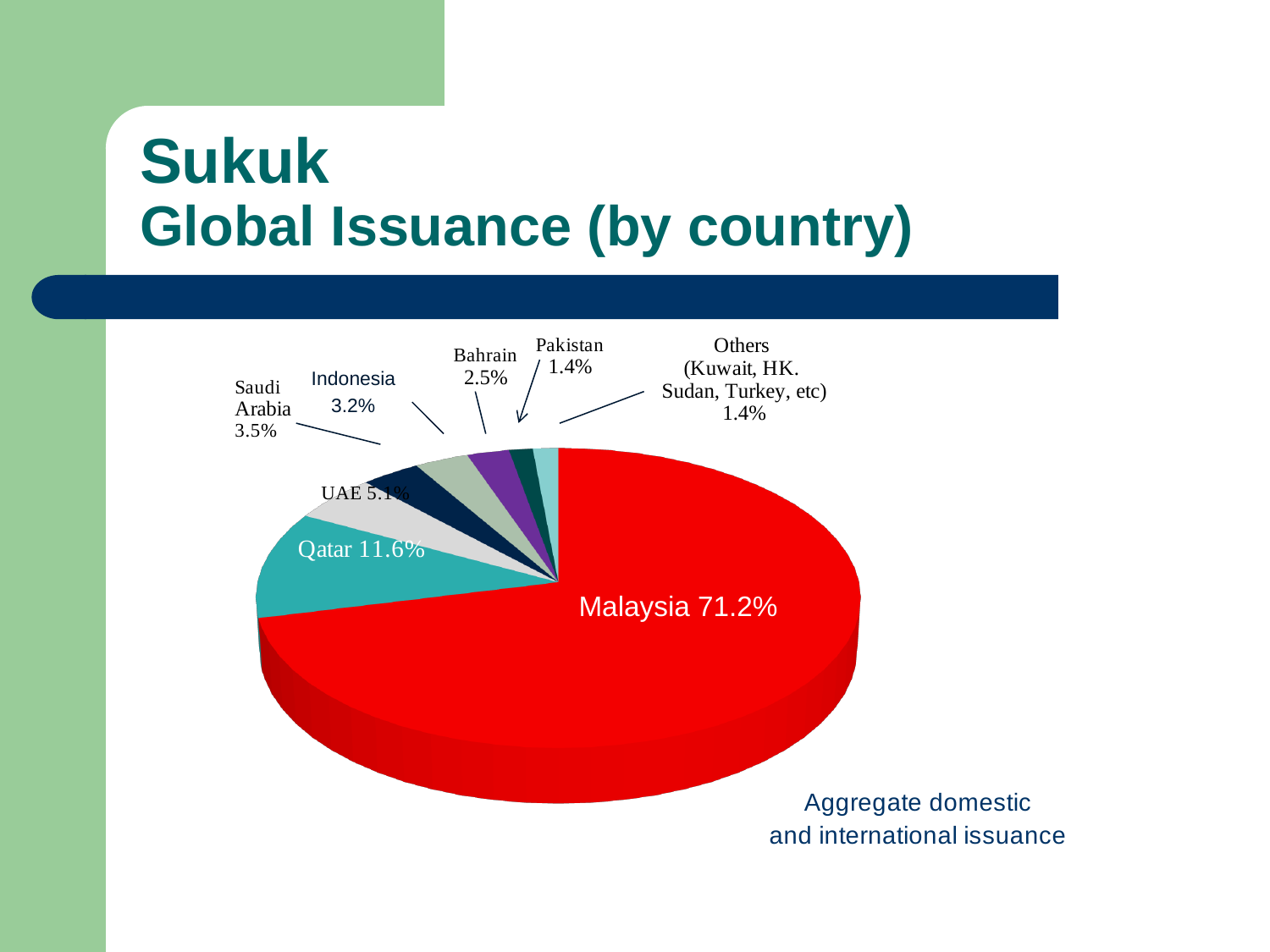
What kind of chart is shown on the slide? Pie chart What is the value shown for Qatar? 11.6% What is the value shown for Pakistan? 1.4% Which slice is larger, Indonesia or Saudi Arabia? Saudi Arabia What is the value shown for Saudi Arabia? 3.5% What share of global sukuk issuance does Malaysia account for? 71.2% What is the difference between Malaysia's share and Qatar's share? 59.6% Which country has the largest slice of the pie? Malaysia What is the value shown for UAE? 5.1% What is the value shown for Bahrain? 2.5% What is the title of the slide containing the chart? Sukuk Global Issuance (by country) How many slices does the pie chart have? 8